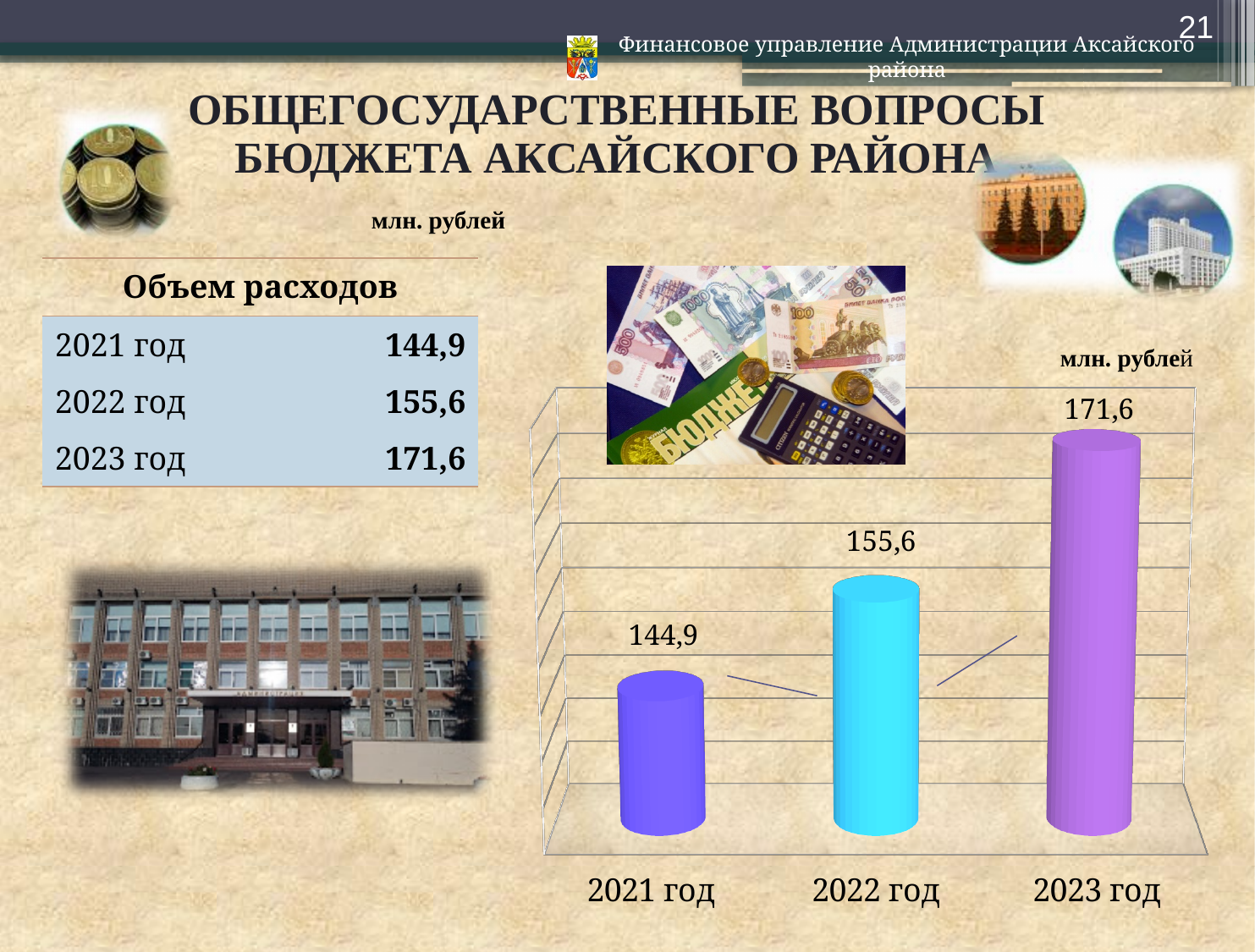
What is the value shown for 2021 год on the chart? 144,9 How many bars are shown on the chart? 3 What kind of chart is shown on the slide? bar chart Do the values rise or fall from 2021 год to 2023 год? rise What is the value shown for 2022 год on the chart? 155,6 What is the difference between the values for 2022 год and 2021 год? 10,7 Which is larger, the value for 2022 год or the value for 2023 год? 2023 год What is the difference between the values for 2023 год and 2021 год? 26,7 What unit is indicated above the chart? млн. рублей Which year has the highest value on the chart? 2023 год Which year has the lowest value on the chart? 2021 год What is the value shown for 2023 год on the chart? 171,6